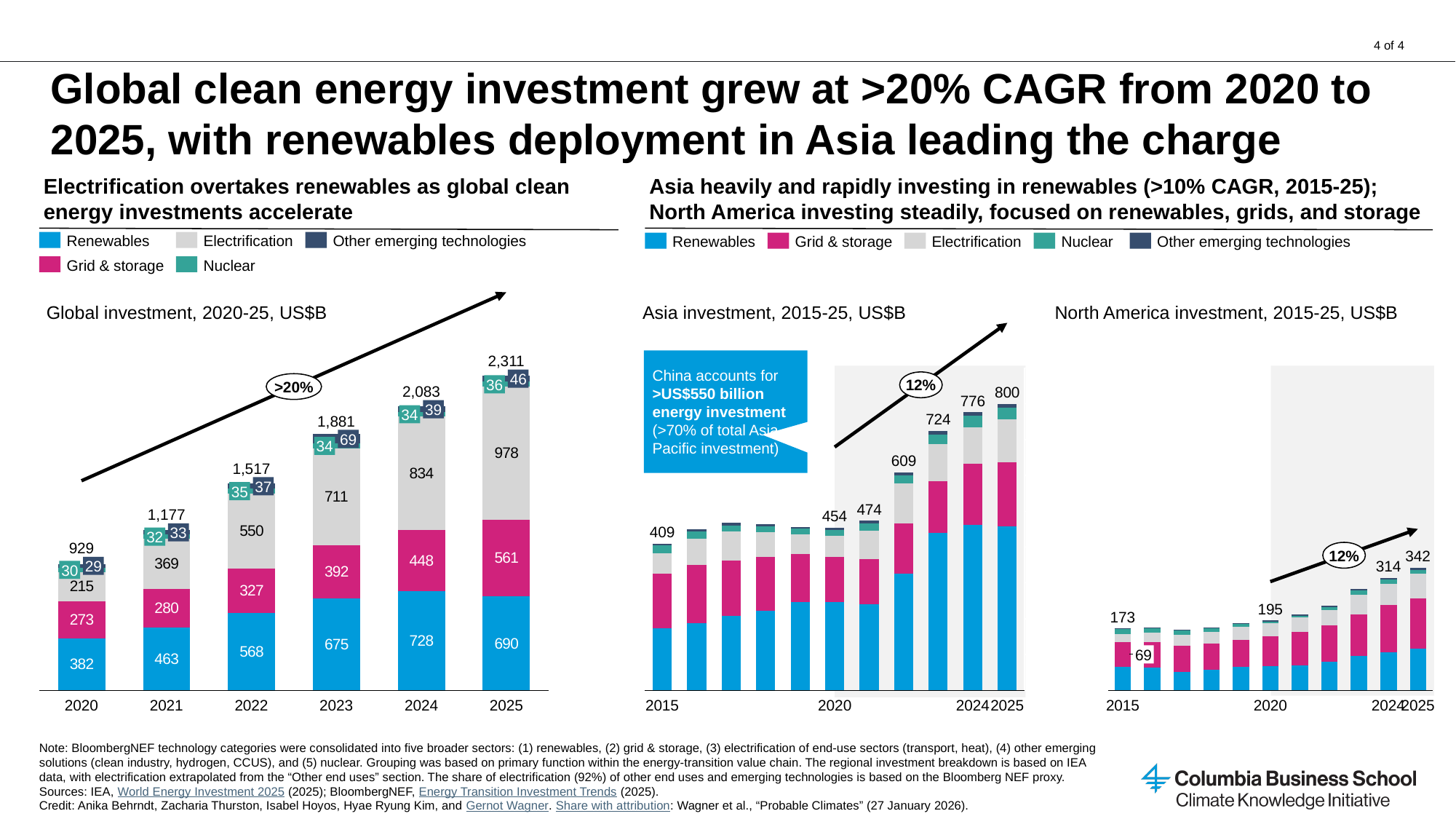
In the Global investment chart, what is the total for the 2025 bar? 2,311 In the North America investment chart, what is the total investment in 2024? 314 In the Global investment chart, which year has the highest total investment? 2025 In the Global investment chart, what is the value for Electrification in 2025? 978 Which is larger in 2025: the Asia investment total or the North America investment total? Asia In the Global investment chart, what is the value for Renewables in 2022? 568 In the Global investment chart, how many years are shown on the x axis? 6 In the Asia investment chart, what is the difference between the 2025 total and the 2015 total? 391 In the Asia investment chart, what is the total investment in 2025? 800 What kind of chart is the Global investment chart? Stacked bar chart In the Global investment chart, what is the difference between Electrification and Renewables in 2025? 288 How many series does the legend of the Global investment chart list? 5